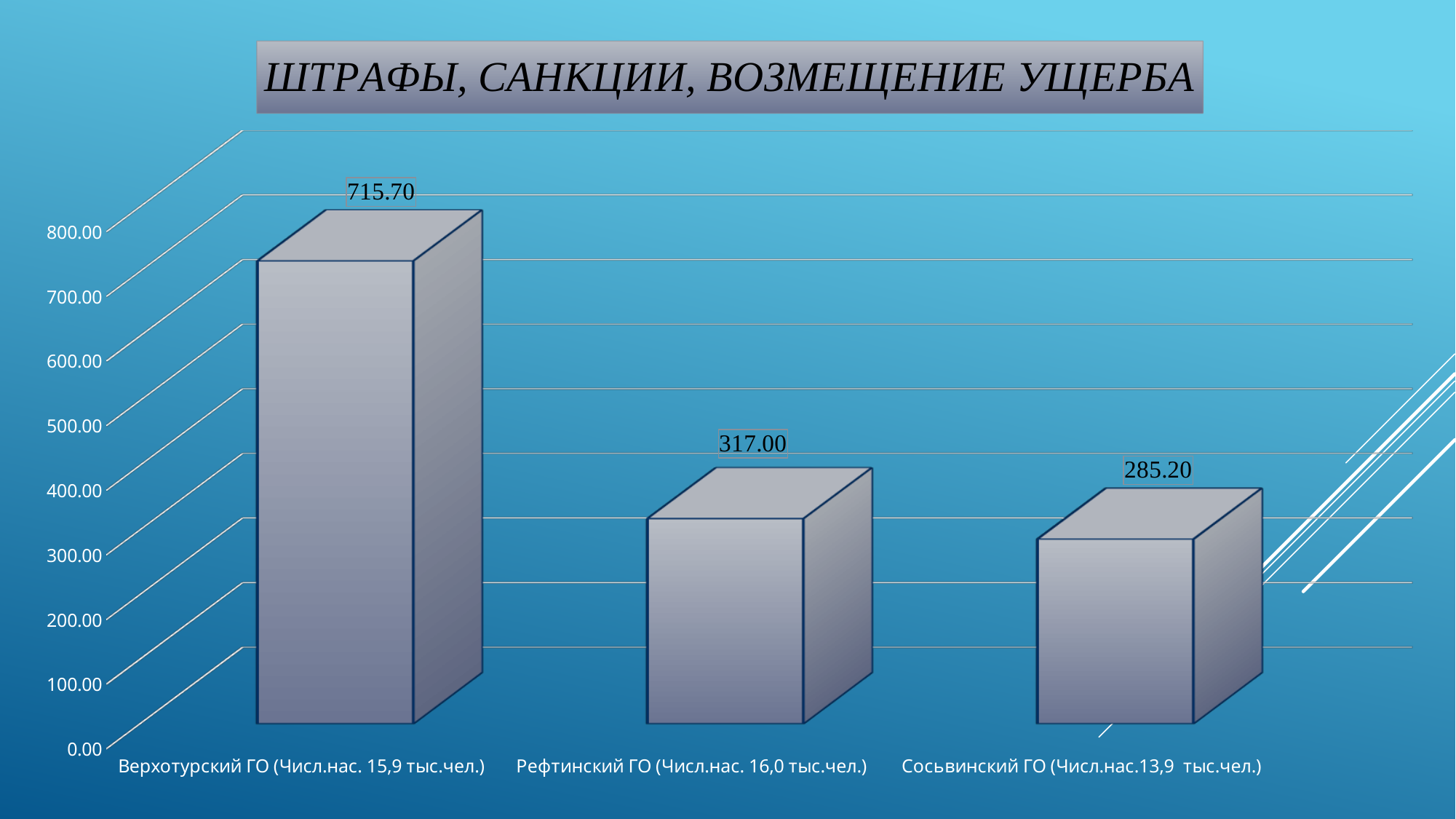
What is the title of the chart? ШТРАФЫ, САНКЦИИ, ВОЗМЕЩЕНИЕ УЩЕРБА What is the difference between the values for Верхотурский ГО and Рефтинский ГО? 398.70 What is the value for Сосьвинский ГО? 285.20 What is the difference between the values for Рефтинский ГО and Сосьвинский ГО? 31.80 Is the value for Верхотурский ГО greater or less than 700.00? greater Which category has the lowest value? Сосьвинский ГО What is the value for Рефтинский ГО? 317.00 What is the value for Верхотурский ГО? 715.70 What kind of chart is shown on the slide? bar chart How many categories are shown in the chart? 3 Which is larger, the value for Рефтинский ГО or the value for Сосьвинский ГО? Рефтинский ГО Which category has the highest value? Верхотурский ГО